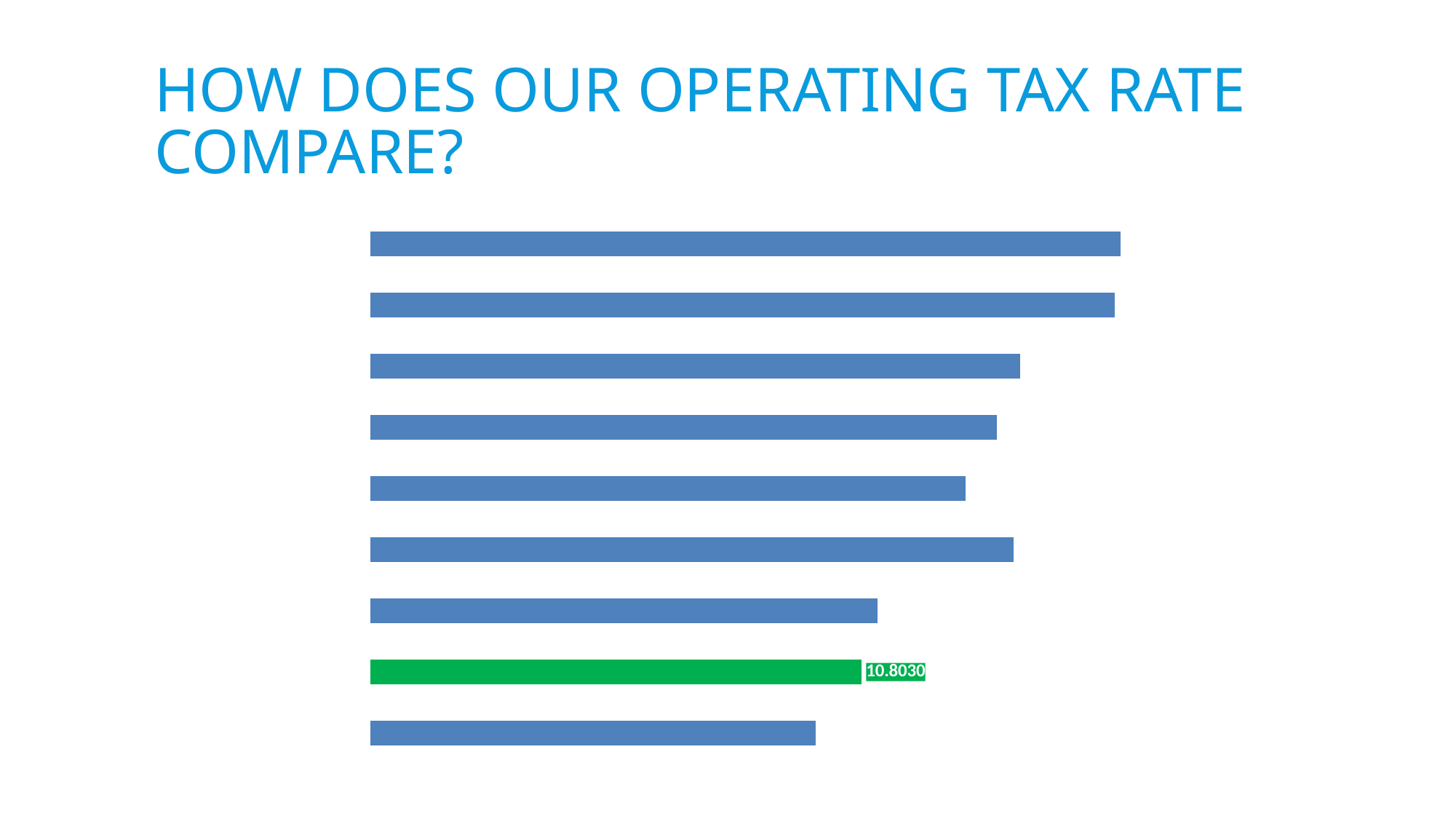
What kind of chart is shown on the slide? Bar chart What colour is the highlighted bar that has a data label? Green Which bar in the chart is the longest, by position? The top bar Is the green bar longer or shorter than the bar directly above it? Shorter Which bar is the longest in the chart: the top bar or the bottom bar? The top bar What is the title of the slide containing the chart? HOW DOES OUR OPERATING TAX RATE COMPARE? What value is printed as the data label on the green bar? 10.8030 How many bars in the chart carry a printed data label? 1 Counting from the top, which bar is the green highlighted bar? The 8th bar Which bar in the chart is the shortest, by position? The bottom bar Is the green bar longer or shorter than the bar directly below it? Longer How many bars does the chart contain? 9